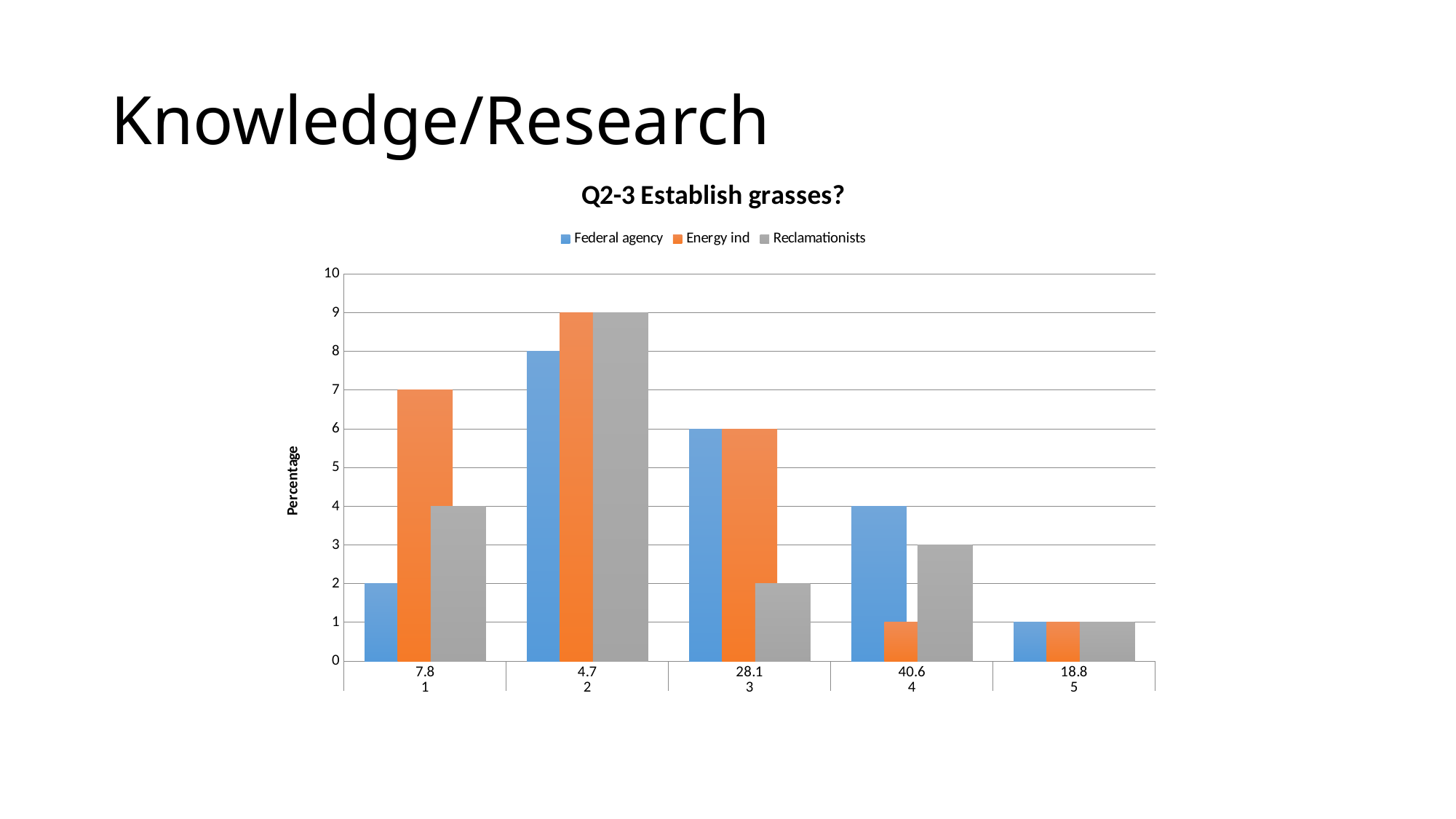
How many series does the legend list? 3 What type of chart is shown on the slide? bar chart In which category is the Energy ind value lowest? 4 (40.6) and 5 (18.8) In which category is the Federal agency value highest? 2 (4.7) What is the value for Reclamationists in category 3 (28.1)? 2 What is the value for Energy ind in category 1 (7.8)? 7 In category 4 (40.6), which is larger: Federal agency or Reclamationists? Federal agency How many categories are shown on the x axis? 5 What is the label on the vertical axis? Percentage What is the value for Federal agency in category 2 (4.7)? 8 What is the title of the chart? Q2-3 Establish grasses? What is the difference between the Energy ind and Federal agency values in category 1 (7.8)? 5